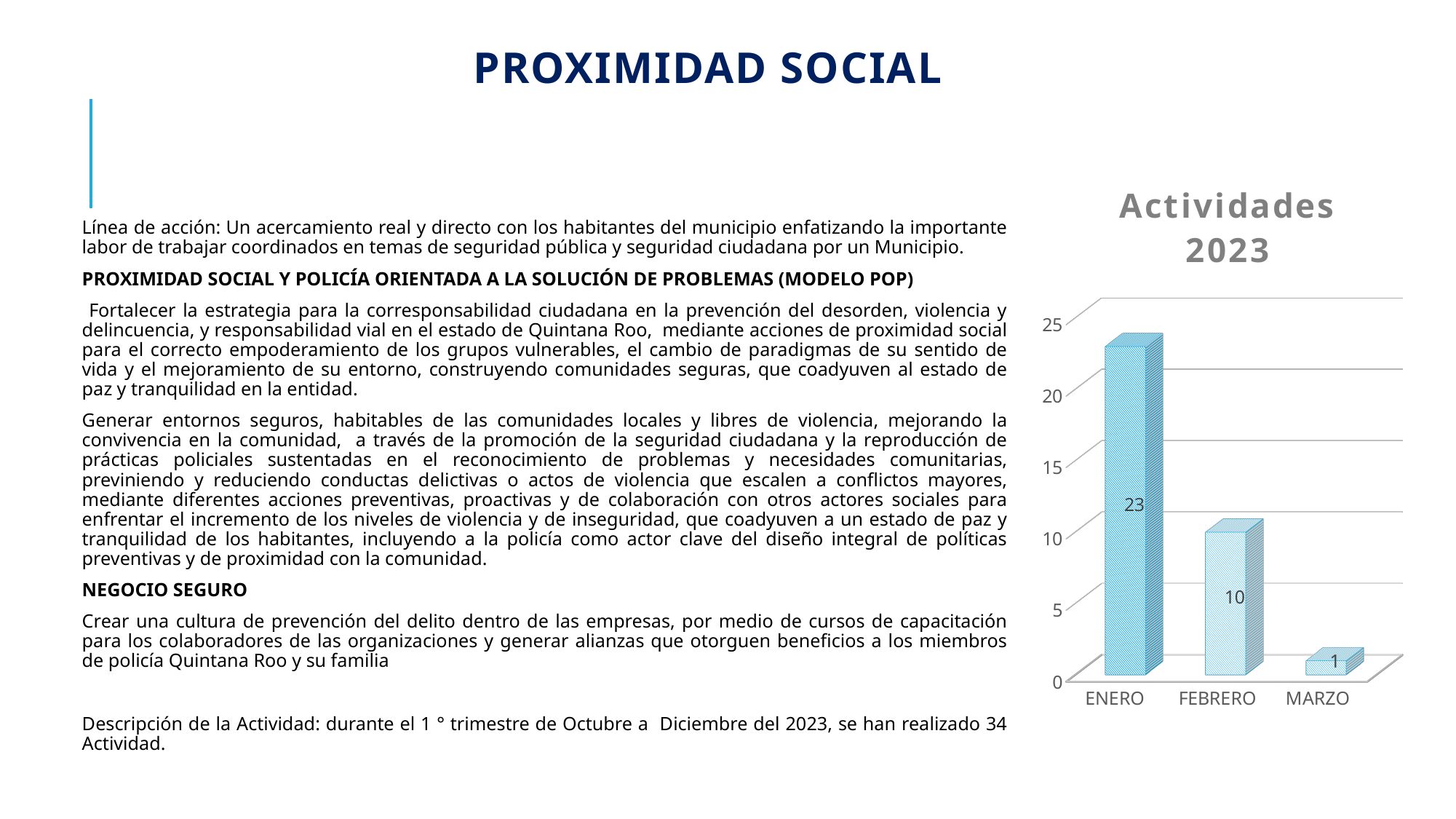
Which is larger in the Actividades 2023 chart, the value for ENERO or the value for FEBRERO? ENERO What is the value for ENERO in the Actividades 2023 chart? 23 Which month has the lowest value in the Actividades 2023 chart? MARZO What is the difference between the values for ENERO and FEBRERO in the Actividades 2023 chart? 13 How many categories are shown in the Actividades 2023 chart? 3 Is the value for ENERO in the Actividades 2023 chart greater or less than 20? greater What is the value for FEBRERO in the Actividades 2023 chart? 10 Do the values in the Actividades 2023 chart rise or fall from ENERO to MARZO? fall What is the difference between the values for FEBRERO and MARZO in the Actividades 2023 chart? 9 What kind of chart is the Actividades 2023 chart? bar chart What is the value for MARZO in the Actividades 2023 chart? 1 Which month has the highest value in the Actividades 2023 chart? ENERO